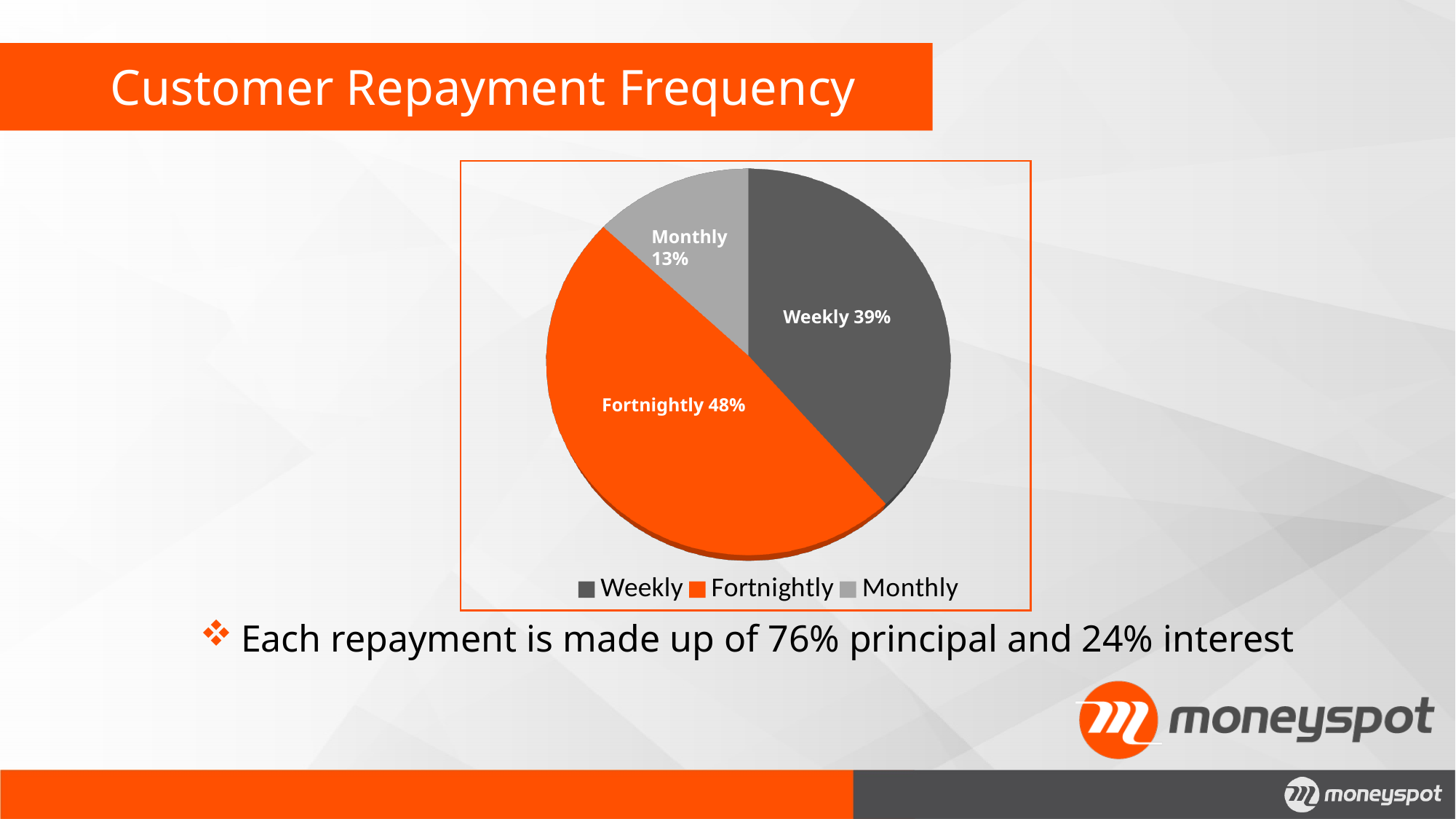
What is the difference in percentage points between the Fortnightly and Weekly shares? 9 How many entries does the legend list? 3 What is the difference in percentage points between the Weekly and Monthly shares? 26 What share of customers repay weekly? 39% Which is larger, the Weekly share or the Monthly share? Weekly What share of customers repay fortnightly? 48% What colour is the Fortnightly slice? orange Which repayment frequency has the smallest share? Monthly What kind of chart is shown on the slide? pie chart How many slices does the pie chart have? 3 Which repayment frequency has the largest share? Fortnightly What share of customers repay monthly? 13%